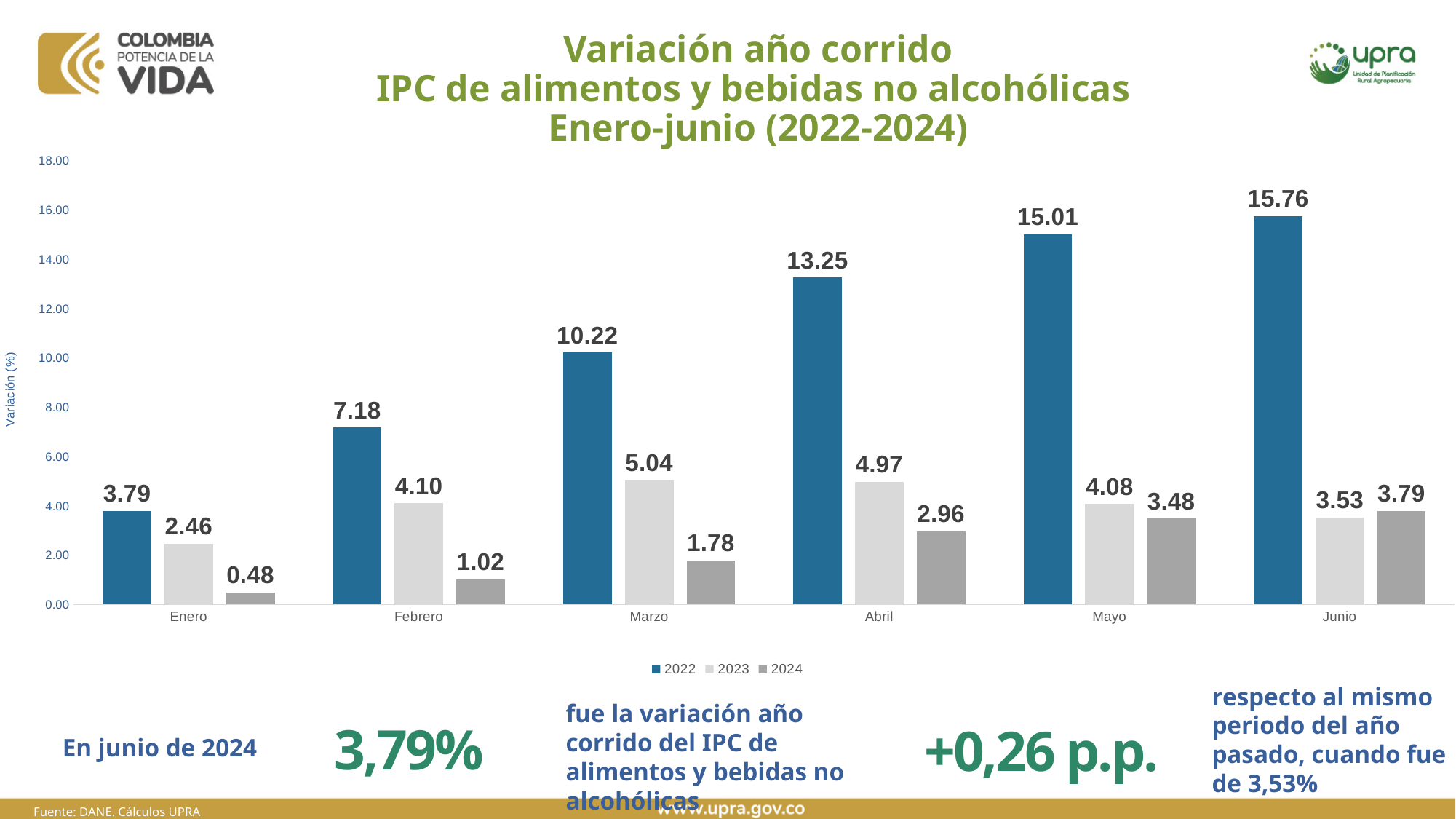
What is the label of the vertical axis? Variación (%) Do the 2022 values rise or fall from Enero to Junio? Rise What is the difference between the 2022 and 2024 values in Junio? 11.97 What kind of chart is shown? Bar chart Which month has the lowest value for the 2024 series? Enero Which month has the highest value for the 2022 series? Junio Which is larger in Mayo, the 2023 value or the 2024 value? 2023 What is the value for 2024 in Enero? 0.48 What is the value for 2023 in Abril? 4.97 How many series does the legend list? 3 What is the value for 2022 in Marzo? 10.22 How many months are shown on the x axis? 6